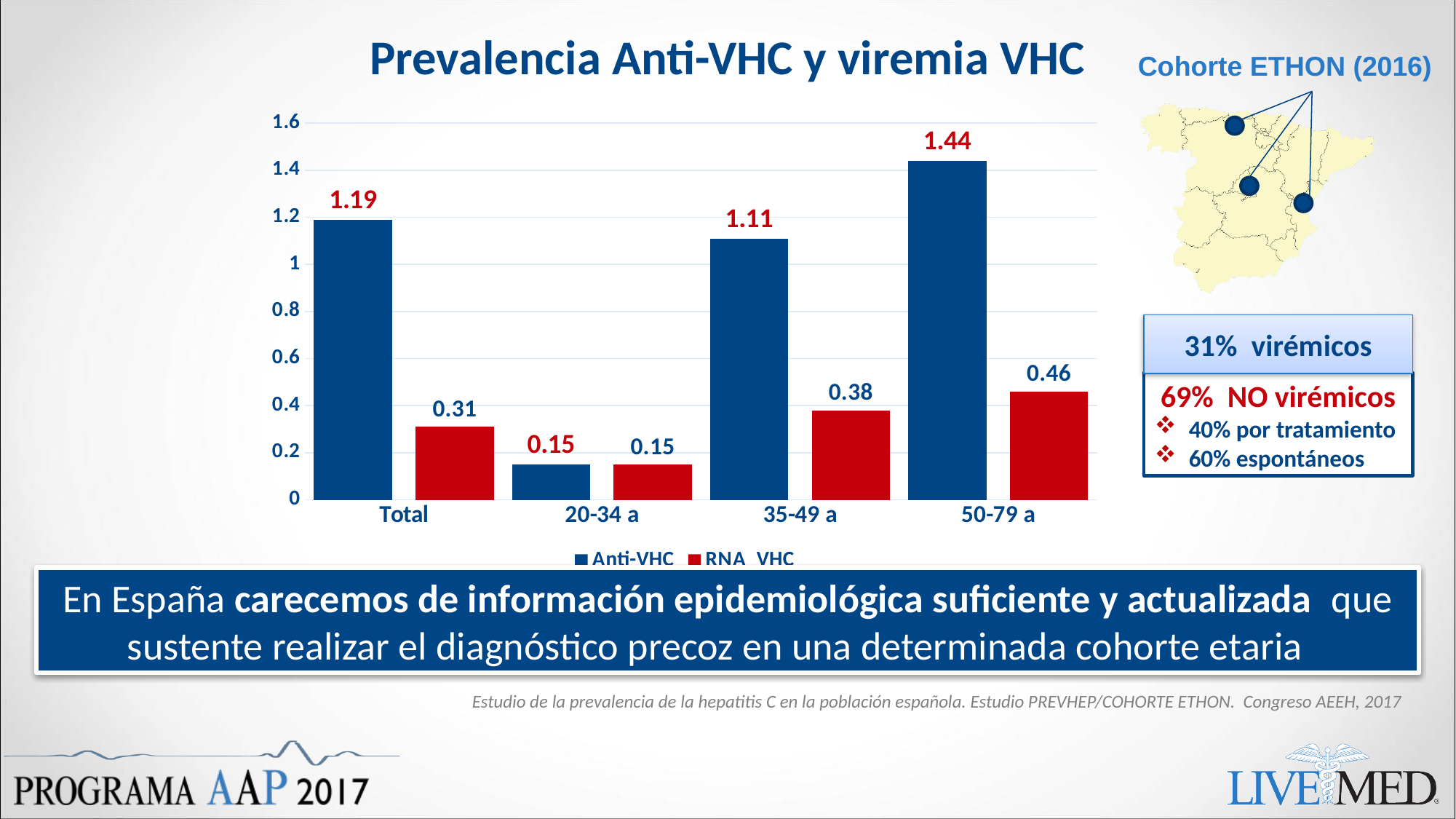
Which colour represents the RNA VHC series? Red Which is larger, the Anti-VHC value for 35-49 a or the Anti-VHC value for Total? Total How many series does the legend list? 2 What is the Anti-VHC value for Total? 1.19 What is the title of the chart? Prevalencia Anti-VHC y viremia VHC Which category has the lowest RNA VHC value? 20-34 a Which age group has the highest Anti-VHC value? 50-79 a What is the difference between the Anti-VHC and RNA VHC values for the 50-79 a group? 0.98 What is the RNA VHC value for the 35-49 a group? 0.38 What is the Anti-VHC value for the 50-79 a group? 1.44 How many categories are shown on the x axis? 4 What kind of chart is shown on the slide? Bar chart